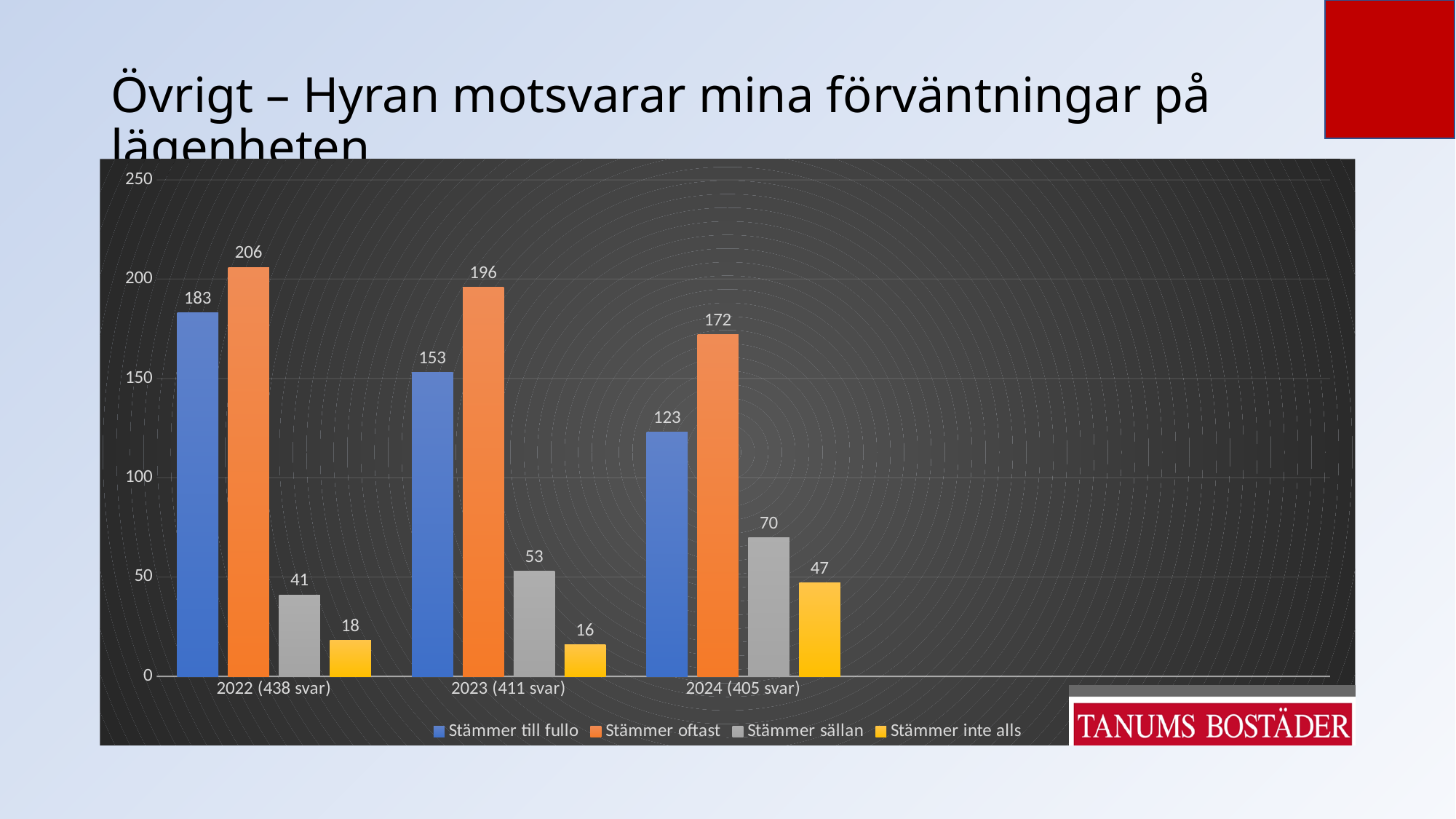
What is the value for "Stämmer till fullo" in 2022 (438 svar)? 183 How many year categories are shown on the x axis? 3 What kind of chart is shown on the slide? Bar chart Which year has the lowest value for "Stämmer till fullo"? 2024 (405 svar) Which is larger: "Stämmer sällan" in 2022 (438 svar) or "Stämmer sällan" in 2023 (411 svar)? Stämmer sällan in 2023 (411 svar) What is the value for "Stämmer sällan" in 2024 (405 svar)? 70 What is the value for "Stämmer oftast" in 2023 (411 svar)? 196 What is the value for "Stämmer inte alls" in 2023 (411 svar)? 16 How many series does the legend list? 4 What is the difference between "Stämmer oftast" and "Stämmer till fullo" in 2024 (405 svar)? 49 Which year has the highest value for "Stämmer oftast"? 2022 (438 svar) Does the value for "Stämmer till fullo" rise or fall from 2022 to 2024? Fall